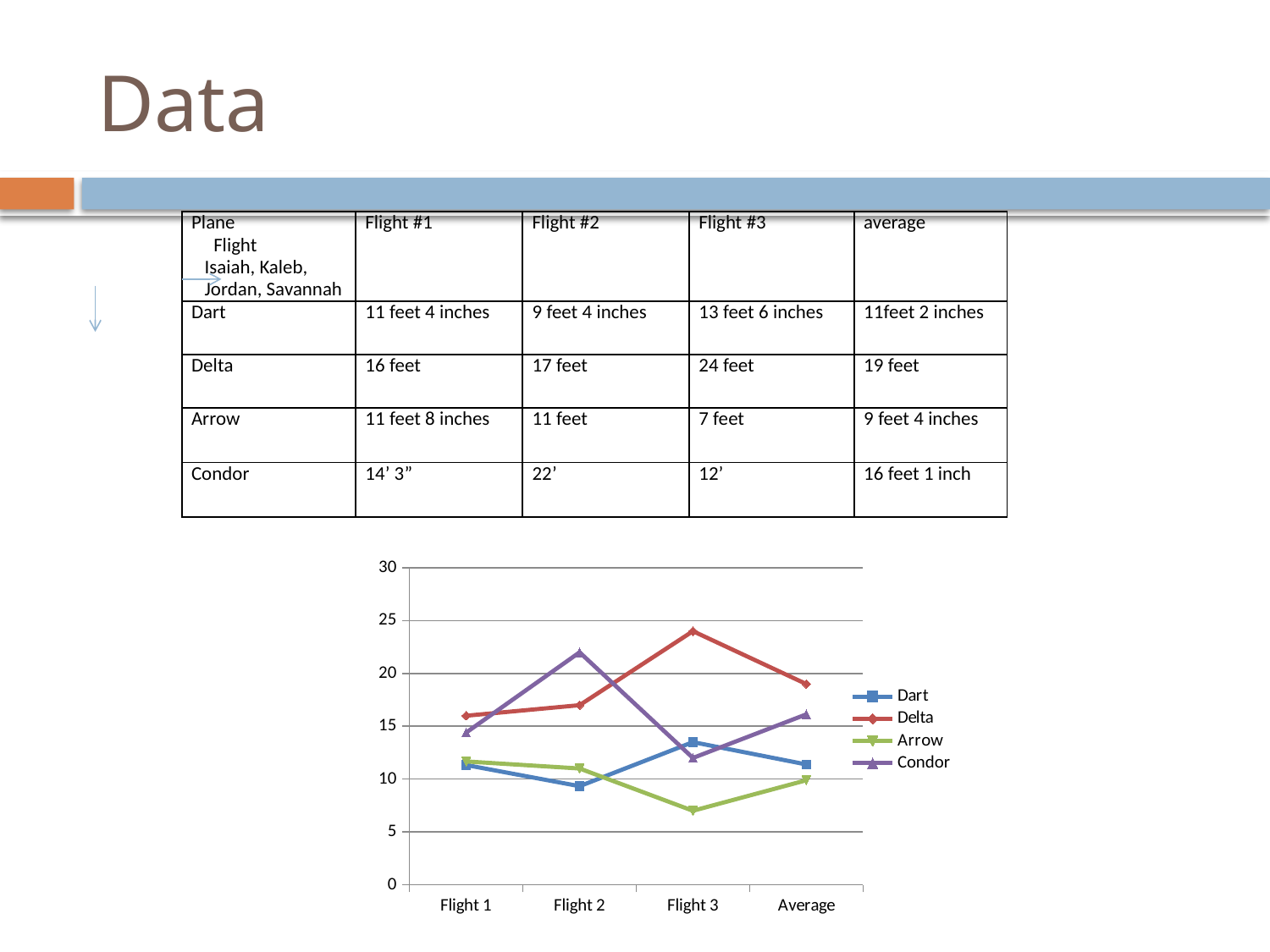
At Flight 2, which is larger: Condor or Delta? Condor Which series has the lowest value at Flight 3? Arrow How many categories are shown along the x axis of the chart? 4 What type of chart is shown on the slide? line chart Is the value for Arrow at Flight 3 greater or less than 10? less Does the Arrow line rise or fall from Flight 1 to Flight 3? falls Which series has the highest value at Flight 3? Delta How many series does the chart's legend list? 4 Does the Delta line rise or fall from Flight 1 to Flight 3? rises Which series has the lowest value at Flight 2? Dart Is the value for Delta at Flight 3 greater or less than 20? greater What are the four entries listed in the chart's legend? Dart, Delta, Arrow, Condor